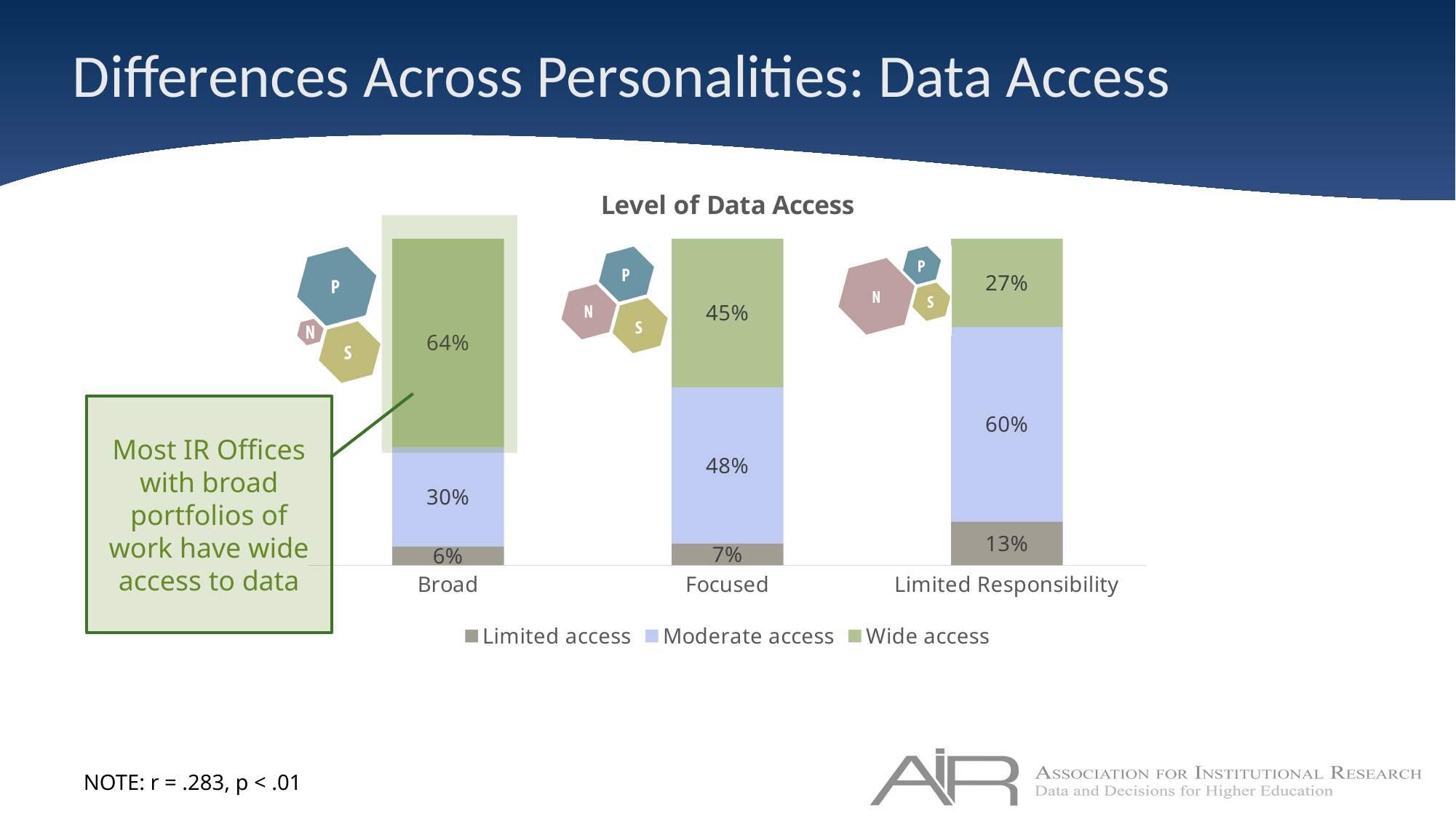
How many series does the legend list? 3 What is the title of the chart? Level of Data Access Which category has the lowest Limited access value? Broad What is the difference between the Wide access values for Broad and Limited Responsibility? 37% What is the Limited access value for the Limited Responsibility category? 13% What is the Moderate access value for the Focused category? 48% What is the total of the stacked bar for Focused? 100% What is the Wide access value for the Broad category? 64% Which category has the highest Wide access value? Broad What kind of chart is shown? Stacked bar chart Which is larger: the Moderate access value for Focused or for Limited Responsibility? Limited Responsibility How many categories are shown on the x axis? 3